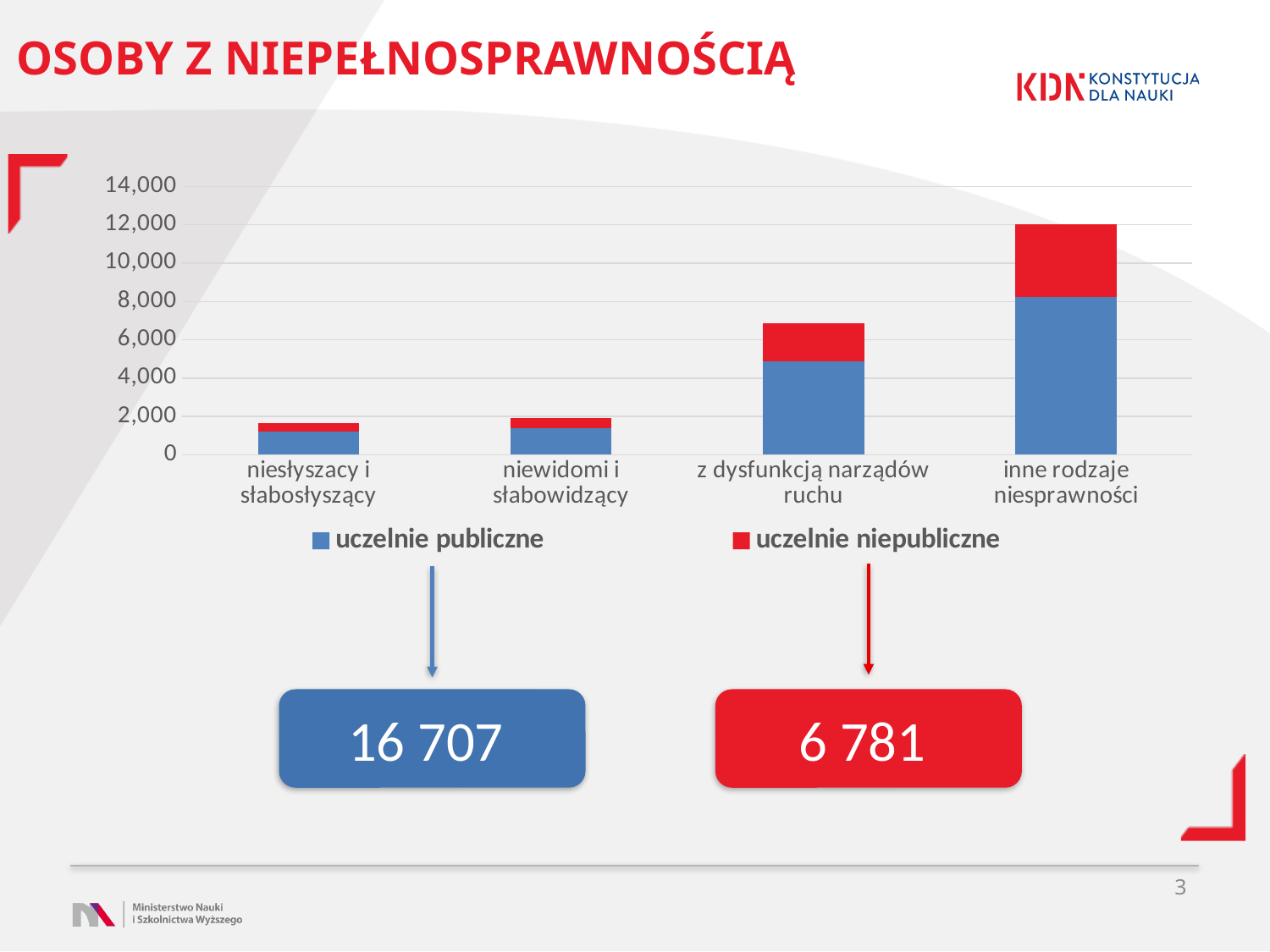
How many categories are shown on the x axis of the chart? 4 Which is larger, the total bar for 'niewidomi i słabowidzący' or for 'z dysfunkcją narządów ruchu'? z dysfunkcją narządów ruchu Which category has the lowest total bar in the chart? niesłyszacy i słabosłyszący Is the total bar for 'inne rodzaje niesprawności' greater or less than 10,000? greater How many series does the chart legend list? 2 Which category has the highest total bar in the chart? inne rodzaje niesprawności What kind of chart is shown on the slide? bar chart Is the total bar for 'z dysfunkcją narządów ruchu' greater or less than 8,000? less What total is shown in the box for 'uczelnie publiczne'? 16 707 Which colour represents 'uczelnie niepubliczne' in the chart? red Is the total bar for 'z dysfunkcją narządów ruchu' greater or less than 6,000? greater